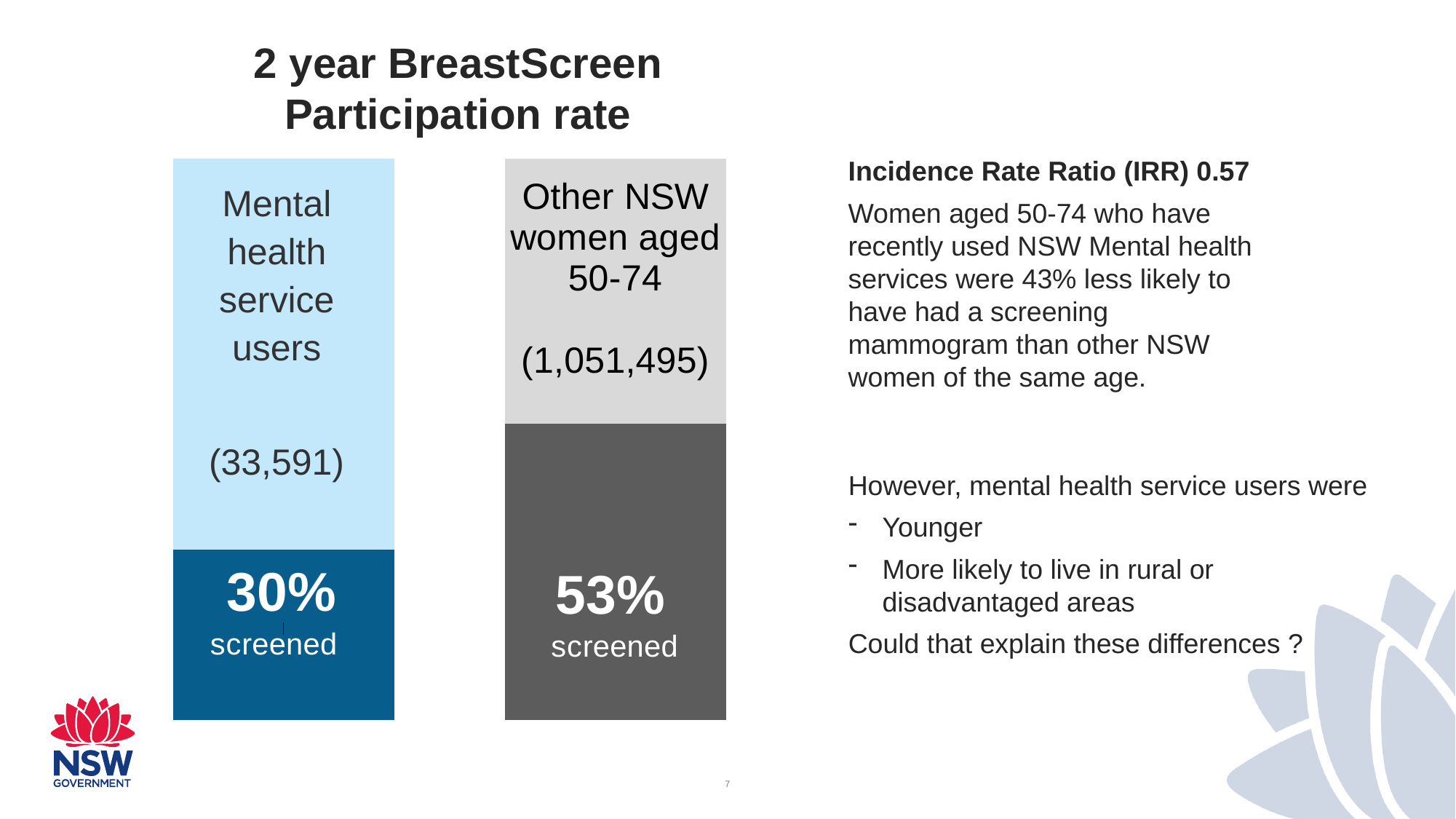
How many other NSW women aged 50-74 are in the group shown in the chart? 1,051,495 What Incidence Rate Ratio (IRR) is stated on the slide? 0.57 Is the screening rate for mental health service users greater or less than the rate for other NSW women aged 50-74? less Which group has the higher screening participation rate? Other NSW women aged 50-74 What is the 2 year BreastScreen participation rate for other NSW women aged 50-74? 53% What is the title of the chart? 2 year BreastScreen Participation rate Which group has the lower screening participation rate? Mental health service users How many mental health service users are in the group shown in the chart? 33,591 How many groups are compared in the chart? 2 What kind of chart is shown on the slide? Bar chart What is the 2 year BreastScreen participation rate for mental health service users? 30% What is the difference in percentage points between the screening rates of other NSW women aged 50-74 and mental health service users? 23 percentage points